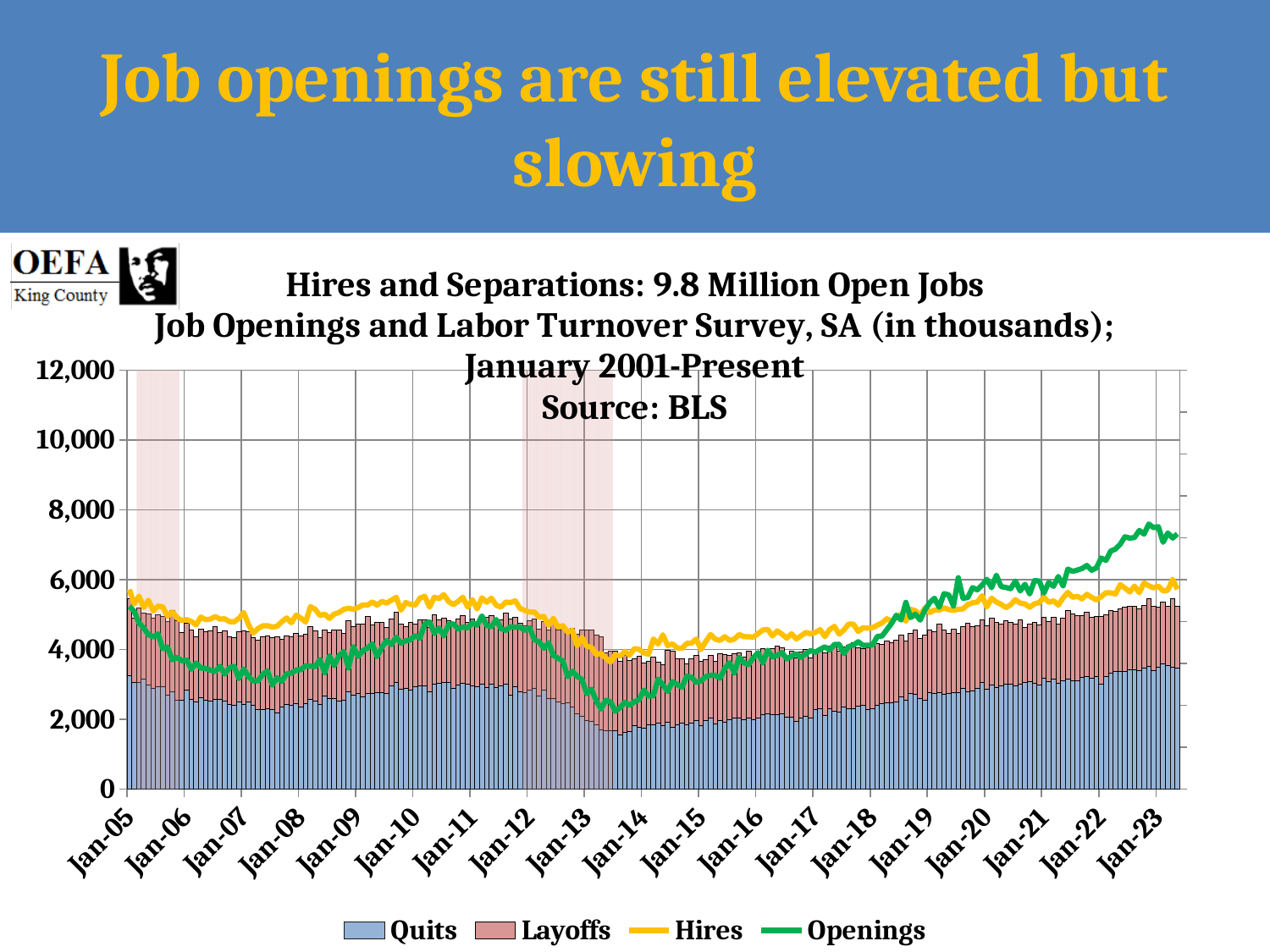
At Jan-23, which is higher: Openings or Hires? Openings Do Openings rise or fall between Jan-12 and Jan-14? fall How many series does the legend list? 4 Is the value of Openings at Jan-23 greater or less than 6,000? greater Which series is plotted as a green line? Openings What kind of chart is this? A combination chart of stacked bars and lines What series are listed in the legend? Quits, Layoffs, Hires, Openings Is the value of Hires at Jan-05 greater or less than 4,000? greater Do Openings rise or fall between Jan-19 and Jan-23? rise Is the value of Openings at Jan-07 greater or less than 4,000? less At Jan-14, which is higher: Hires or Openings? Hires